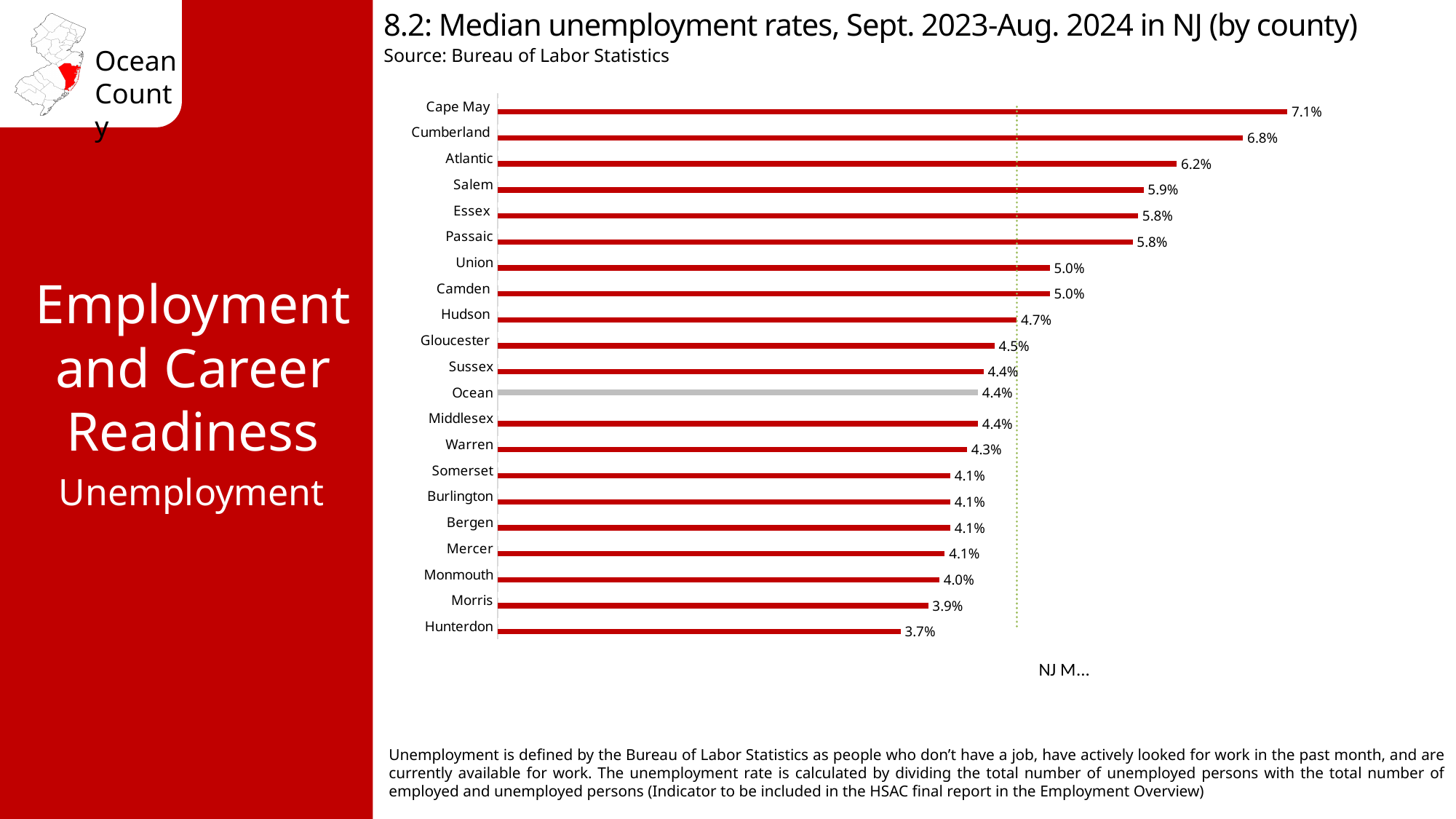
Which county has a higher median unemployment rate, Monmouth or Morris? Monmouth Which county has the highest median unemployment rate? Cape May What is the difference between the median unemployment rates of Cape May and Hunterdon? 3.4% Which county has a higher median unemployment rate, Salem or Gloucester? Salem What type of chart is used to show the median unemployment rates by county? Bar chart What is the median unemployment rate for Ocean County? 4.4% How many counties are shown in the chart? 21 What is the median unemployment rate for Cape May? 7.1% What is the median unemployment rate for Hudson? 4.7% Which county's bar is shown in grey rather than red? Ocean What is the difference between the median unemployment rates of Cumberland and Atlantic? 0.6% Which county has the lowest median unemployment rate? Hunterdon